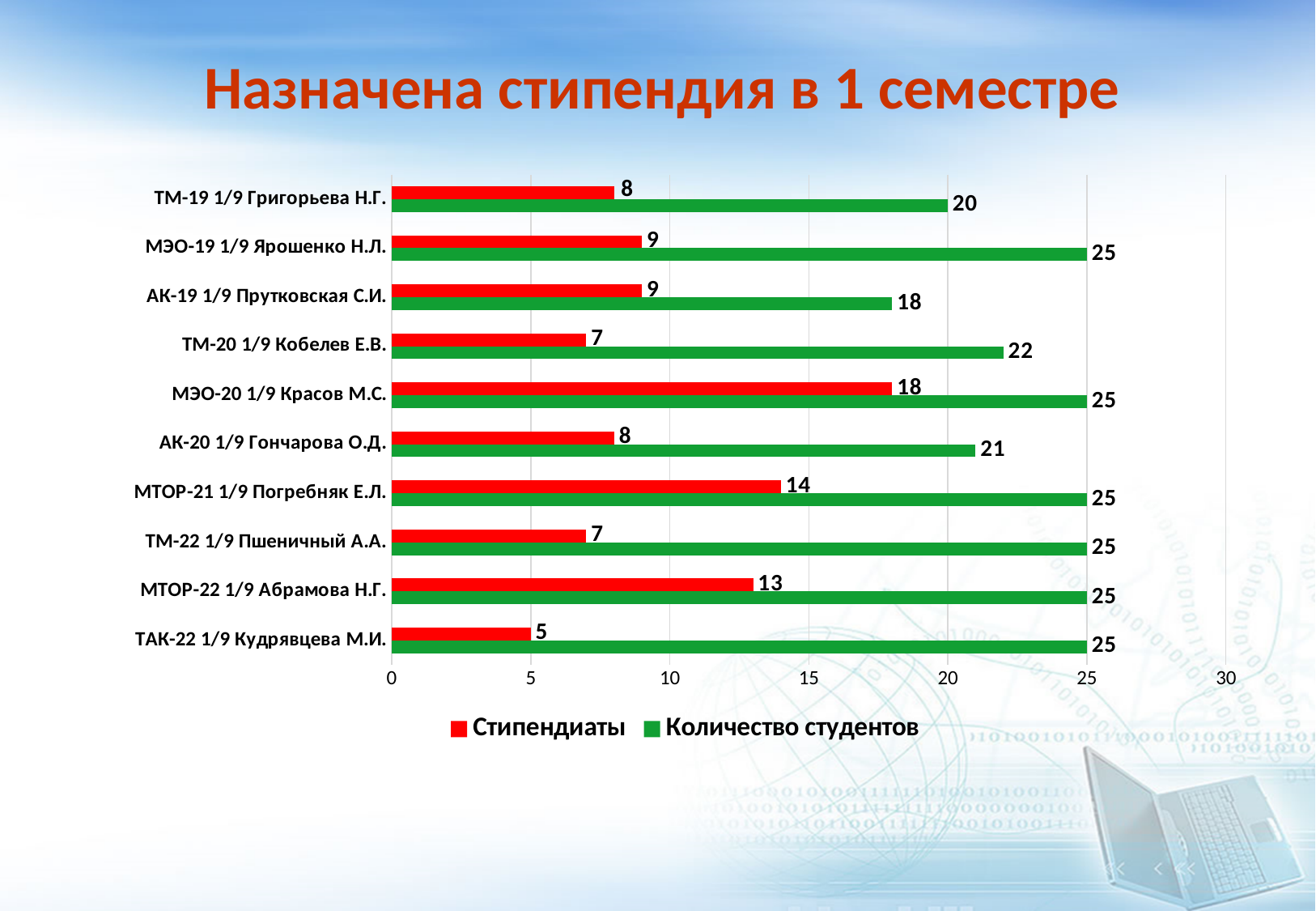
Which category has the highest value for Стипендиаты? МЭО-20 1/9 Красов М.С. What is the title of the slide? Назначена стипендия в 1 семестре What is the value of Стипендиаты for ТАК-22 1/9 Кудрявцева М.И.? 5 How many categories are shown on the chart? 10 Which category has the lowest value for Количество студентов? АК-19 1/9 Прутковская С.И. What is the value of Стипендиаты for МЭО-20 1/9 Красов М.С.? 18 What is the difference between Количество студентов and Стипендиаты for ТМ-19 1/9 Григорьева Н.Г.? 12 What kind of chart is shown on the slide? Bar chart What is the value of Количество студентов for ТМ-20 1/9 Кобелев Е.В.? 22 Which category has the lowest value for Стипендиаты? ТАК-22 1/9 Кудрявцева М.И. Which is larger: Стипендиаты for МТОР-21 1/9 Погребняк Е.Л. or Стипендиаты for МТОР-22 1/9 Абрамова Н.Г.? МТОР-21 1/9 Погребняк Е.Л. How many series does the legend list? 2